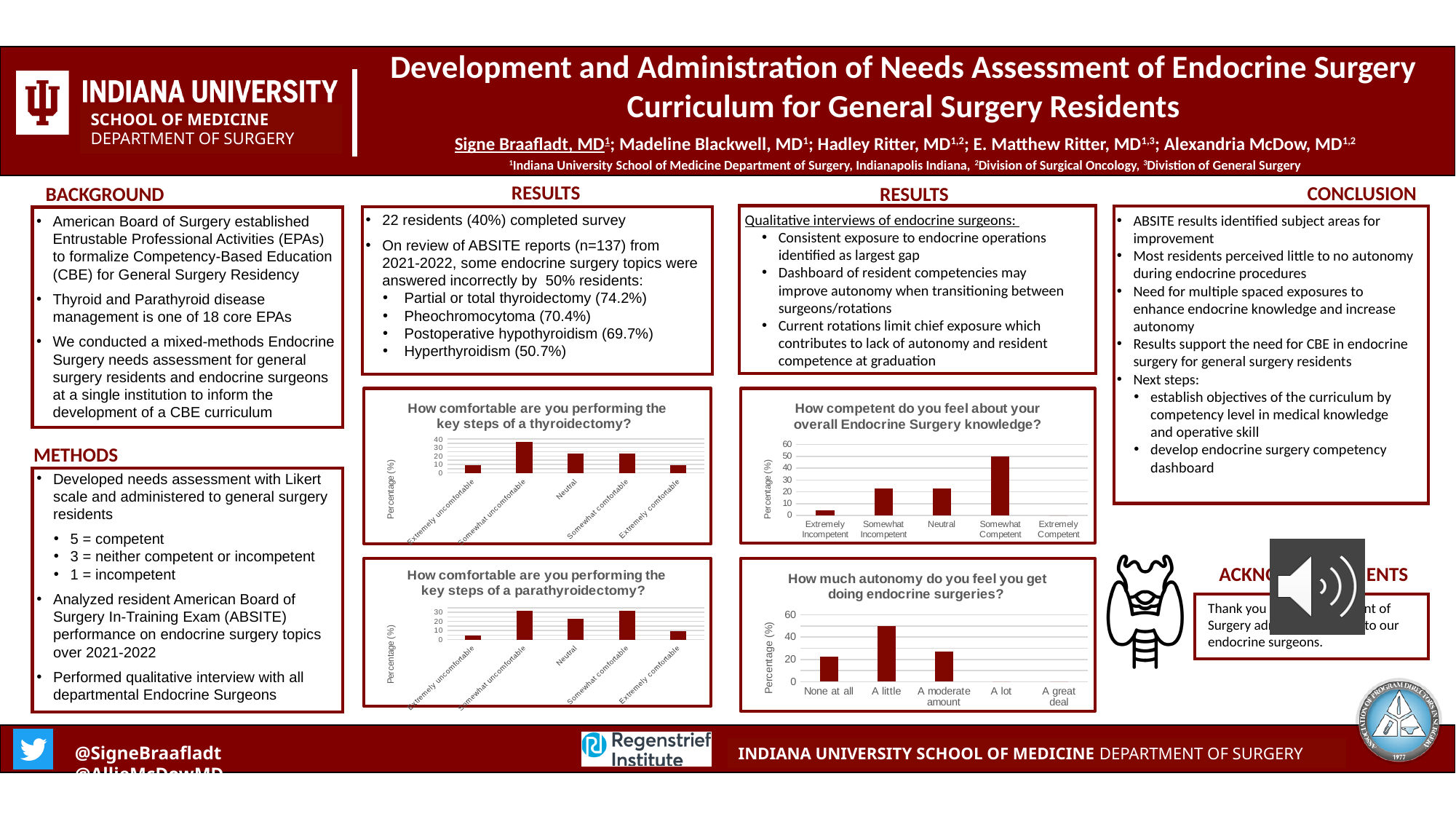
How many categories are shown on the x axis of the chart titled "How much autonomy do you feel you get doing endocrine surgeries?"? 5 In the chart titled "How competent do you feel about your overall Endocrine Surgery knowledge?", which category has the highest value? Somewhat Competent In the chart titled "How much autonomy do you feel you get doing endocrine surgeries?", which is larger, the value for None at all or the value for A moderate amount? A moderate amount What kind of chart is the chart titled "How much autonomy do you feel you get doing endocrine surgeries?"? bar chart In the chart titled "How comfortable are you performing the key steps of a thyroidectomy?", which category has the highest value? Somewhat uncomfortable In the chart titled "How competent do you feel about your overall Endocrine Surgery knowledge?", is the value for Extremely Incompetent greater or less than 10? less In the chart titled "How comfortable are you performing the key steps of a parathyroidectomy?", is the value for Neutral greater or less than 10? greater In the chart titled "How much autonomy do you feel you get doing endocrine surgeries?", which category has the highest value? A little In the chart titled "How competent do you feel about your overall Endocrine Surgery knowledge?", is the value for Somewhat Competent greater or less than 40? greater In the chart titled "How comfortable are you performing the key steps of a parathyroidectomy?", which category has the lowest value? Extremely uncomfortable